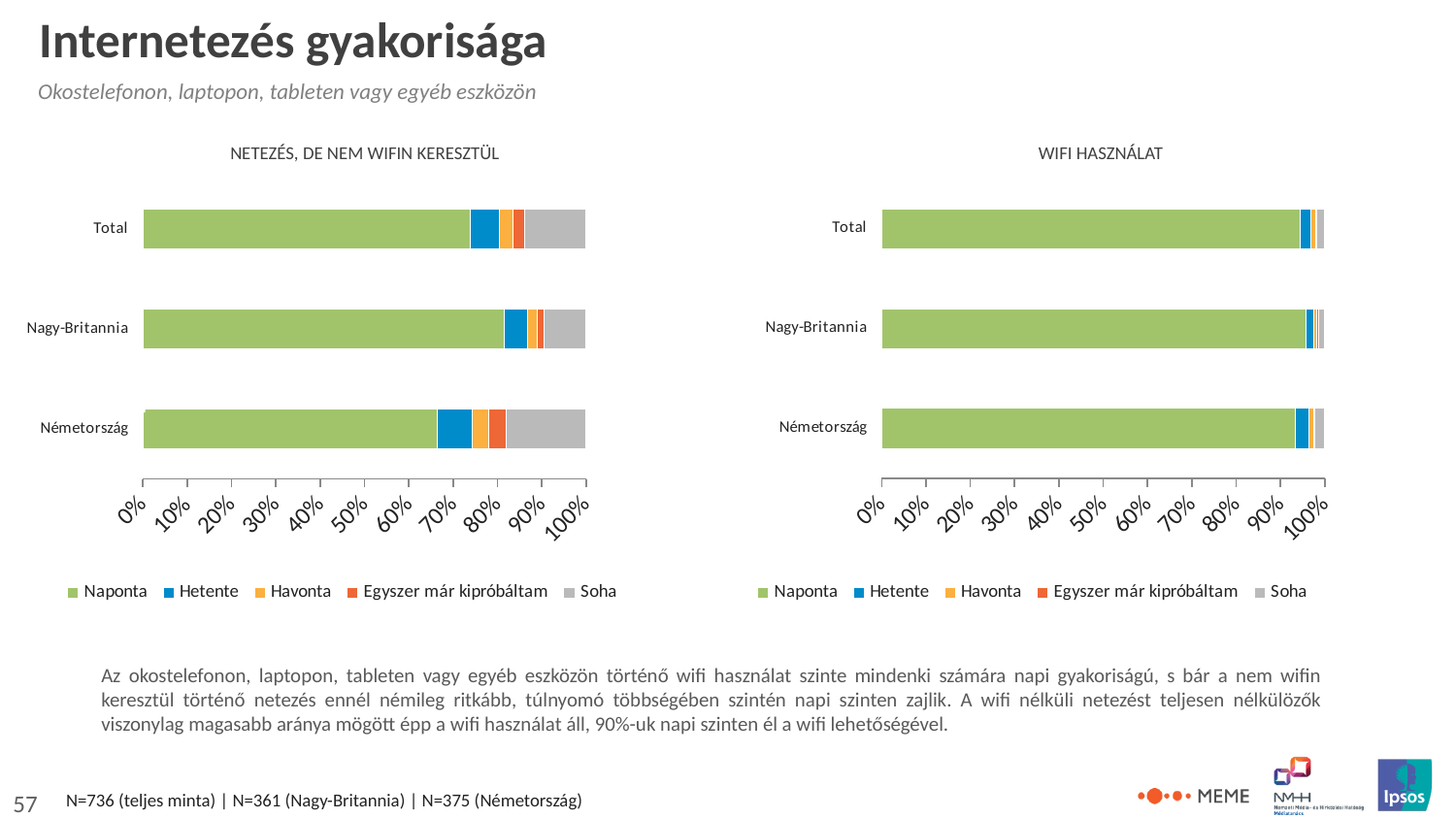
In the 'WIFI HASZNÁLAT' chart, is the 'Naponta' value for Total greater or less than 90%? greater How many series does the legend of the 'NETEZÉS, DE NEM WIFIN KERESZTÜL' chart list? 5 In the 'NETEZÉS, DE NEM WIFIN KERESZTÜL' chart, which category has the largest 'Naponta' segment? Nagy-Britannia In the 'NETEZÉS, DE NEM WIFIN KERESZTÜL' chart, which is larger: the 'Naponta' value for Nagy-Britannia or for Németország? Nagy-Britannia In the 'NETEZÉS, DE NEM WIFIN KERESZTÜL' chart, is the 'Naponta' value for Németország greater or less than 70%? less How many categories are shown on the 'WIFI HASZNÁLAT' chart? 3 In the 'NETEZÉS, DE NEM WIFIN KERESZTÜL' chart, which category has the smallest 'Naponta' segment? Németország What kind of chart is used on the slide for 'NETEZÉS, DE NEM WIFIN KERESZTÜL'? Stacked bar chart Which colour represents 'Soha' in the legend of the 'WIFI HASZNÁLAT' chart? Grey What is the title of the chart on the right side of the slide? WIFI HASZNÁLAT In the 'NETEZÉS, DE NEM WIFIN KERESZTÜL' chart, is the 'Naponta' value for Nagy-Britannia greater or less than 70%? greater In the 'NETEZÉS, DE NEM WIFIN KERESZTÜL' chart, which category has the largest 'Soha' segment? Németország